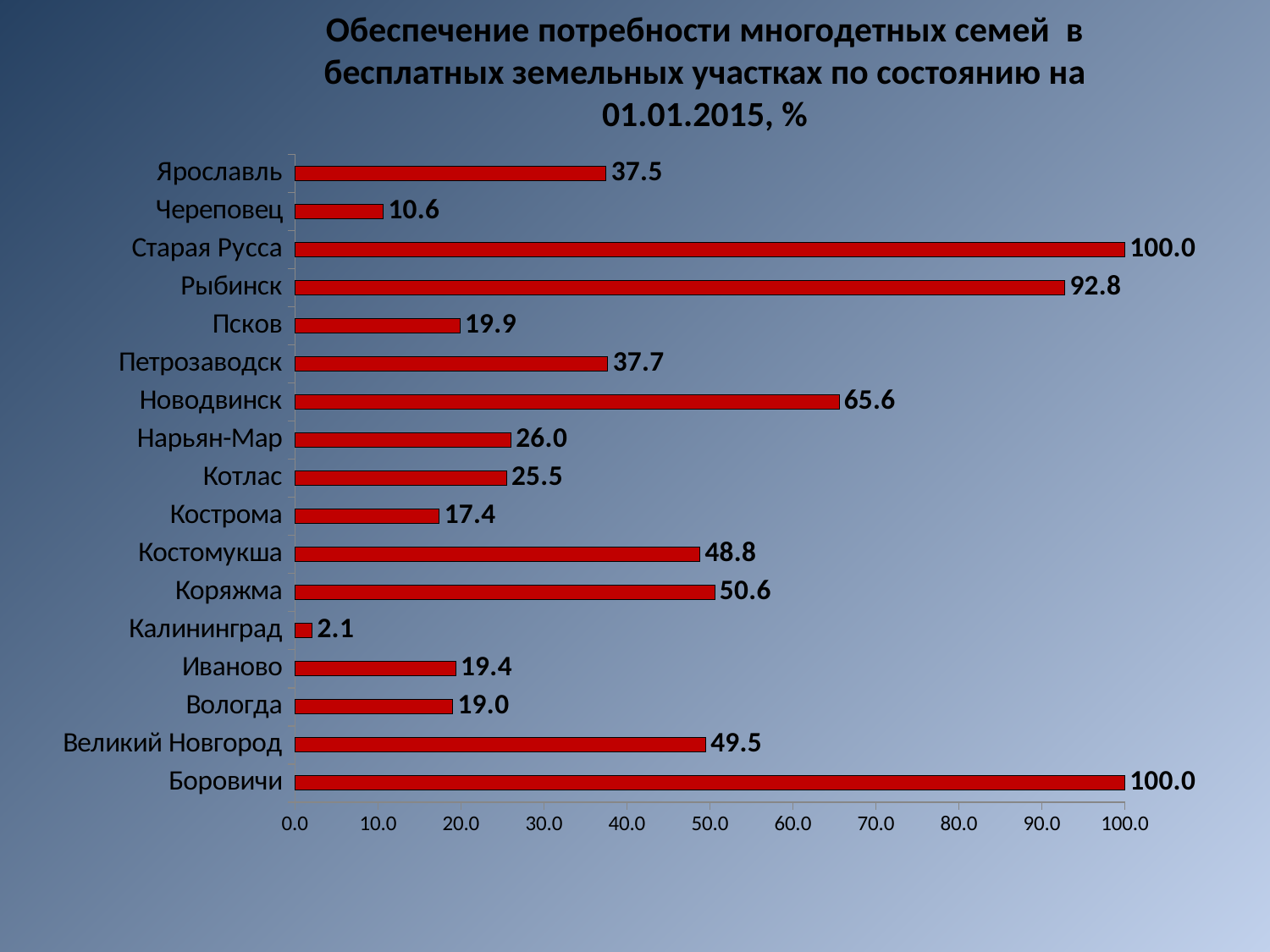
Which has a larger value, Петрозаводск or Ярославль? Петрозаводск What colour are the bars in the chart? red What is the difference between the values for Коряжма and Костомукша? 1.8 What is the value for Рыбинск? 92.8 What is the value for Новодвинск? 65.6 How many cities are shown in the chart? 17 Which two cities share the highest value of 100.0? Старая Русса and Боровичи What is the value for Великий Новгород? 49.5 Which city has the lowest value? Калининград What kind of chart is shown on the slide? bar chart Is the value for Череповец greater or less than 20.0? less What is the value for Калининград? 2.1